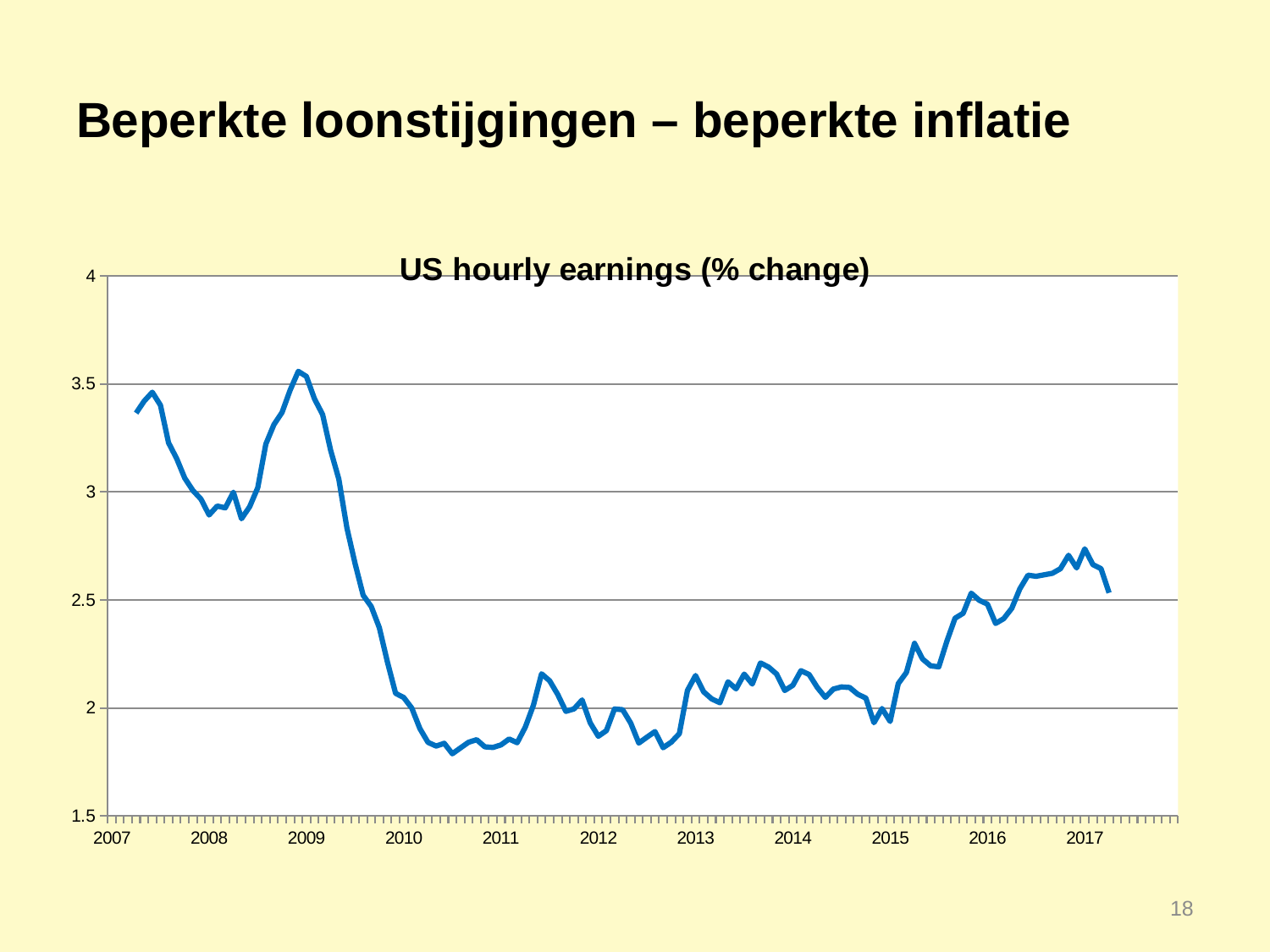
Is the value in mid-2010 greater or less than 2? less How many year labels are shown on the x axis of the chart? 11 Is the value at the start of 2014 greater or less than 2? greater Does the line rise or fall between the start of 2009 and the start of 2010? fall What kind of chart is shown on the slide? line chart What is the title of the chart? US hourly earnings (% change) Is the value at the start of 2017 greater or less than 2.5? greater Which is larger, the value at the start of 2009 or the value at the start of 2012? 2009 Does the line rise or fall between the start of 2015 and the start of 2017? rise